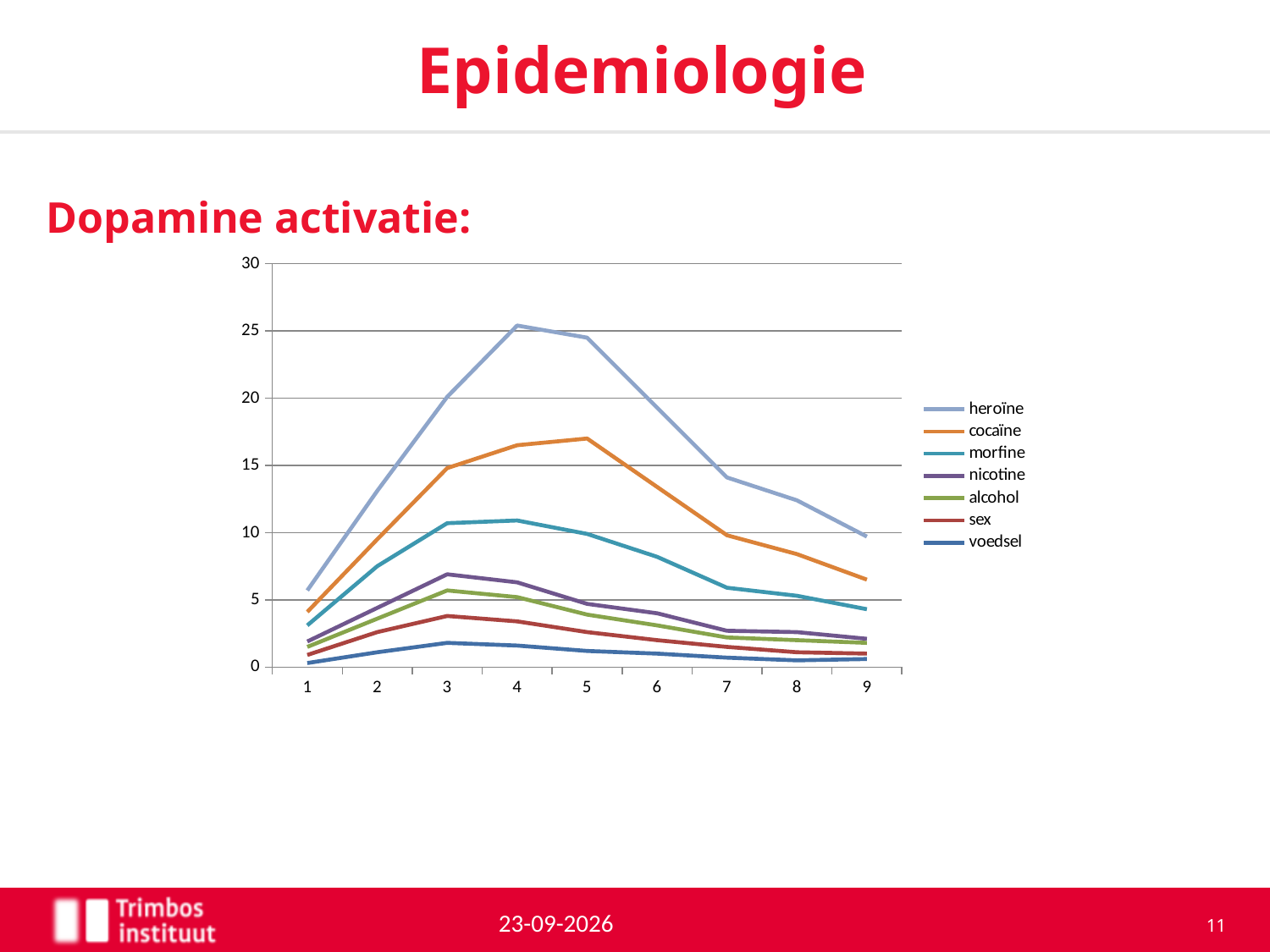
What kind of chart is shown on the slide? line chart How many points are there along the x axis? 9 Does the heroïne line rise or fall from point 5 to point 9? fall Which series is drawn in orange? cocaïne Is the value for morfine at point 4 greater or less than 15? less At point 4, which is larger: heroïne or cocaïne? heroïne Which series reaches the highest value on the chart? heroïne How many series does the legend list? 7